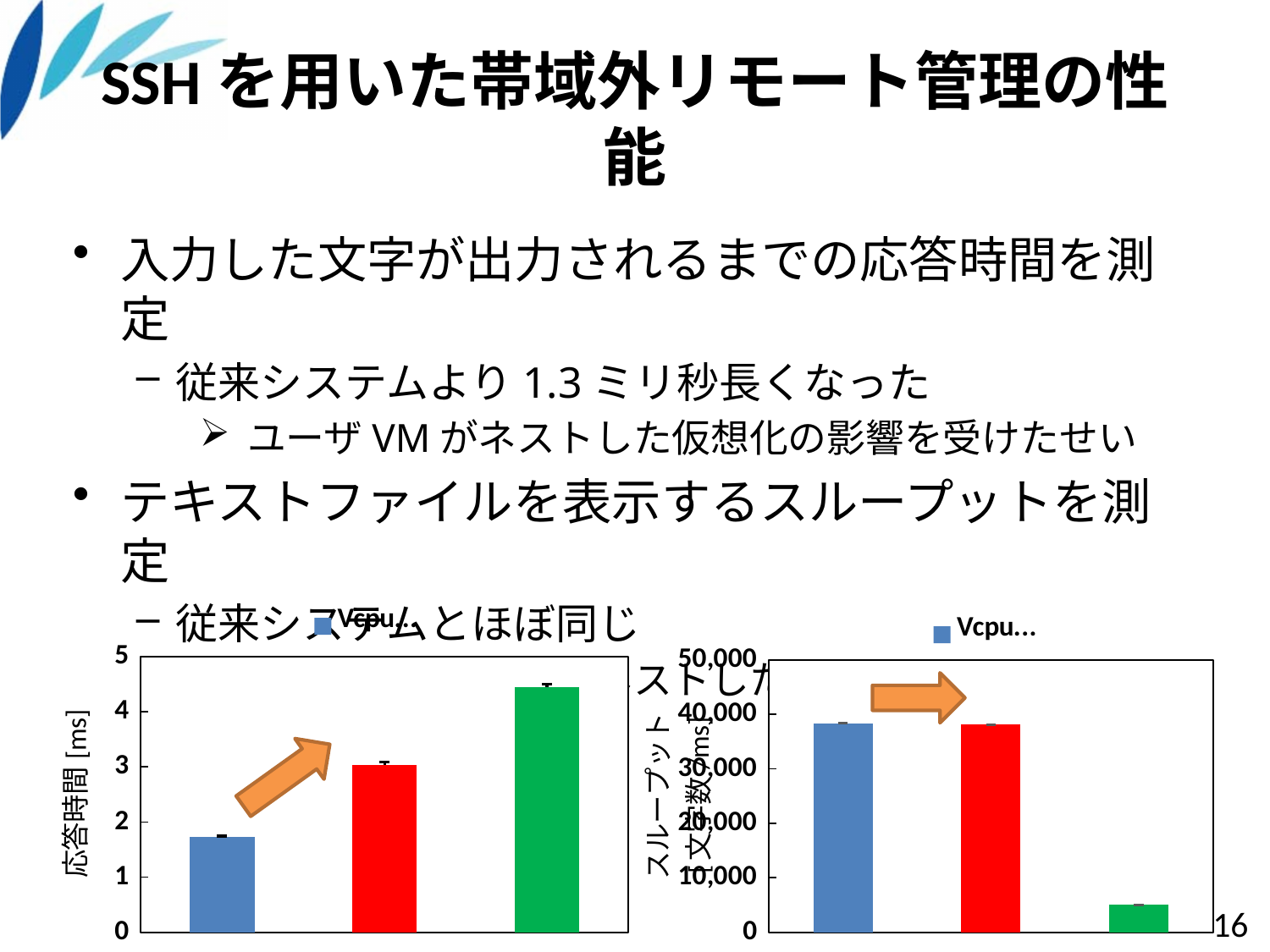
What is the y-axis label of the left chart? 応答時間 [ms] In the left chart (応答時間 [ms]), do the bar values rise or fall from left to right? rise How many bars are plotted in the right chart (throughput)? 3 In the right chart (throughput), is the value of the green bar greater or less than 10,000? less How many bars are plotted in the left chart (応答時間 [ms])? 3 In the right chart (throughput), is the value of the blue bar greater or less than 30,000? greater In the left chart (応答時間 [ms]), is the value of the green bar greater or less than 4? greater In the right chart (throughput), which bar is the shortest: the blue, red or green one? green What kind of chart is the left chart on the slide? bar chart In the left chart (応答時間 [ms]), which bar is the tallest: the blue, red or green one? green In the left chart (応答時間 [ms]), which bar is the shortest: the blue, red or green one? blue